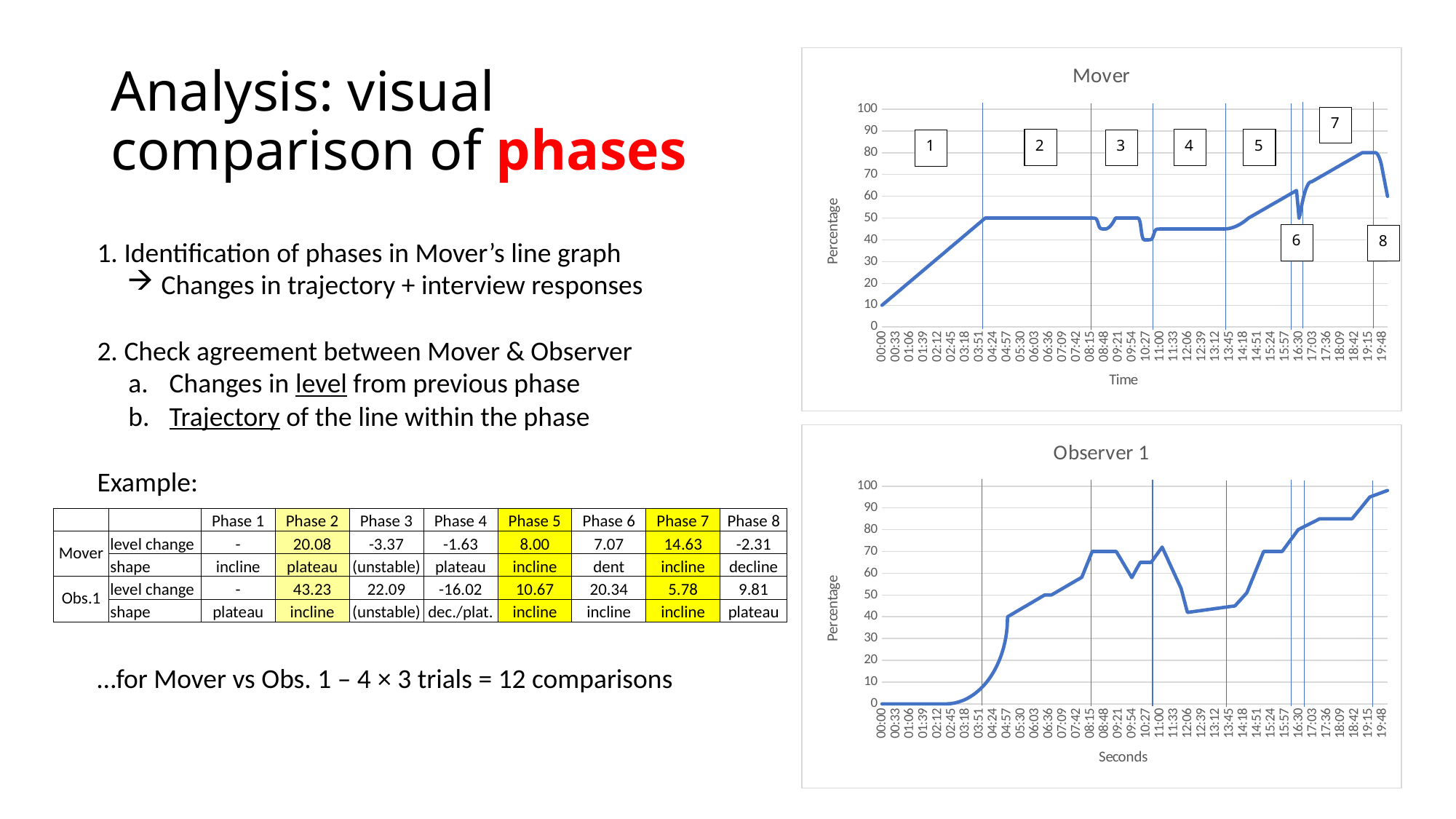
On the Mover chart, is the value at 06:03 greater or less than 40? greater What is the x-axis label of the Observer 1 chart? Seconds On the Observer 1 chart, is the value at 02:12 greater or less than 10? less What kind of chart is the Mover chart? line chart On the Mover chart, does the line rise or fall between 19:15 and 19:48? fall On the Observer 1 chart, is the value at 19:48 greater or less than 90? greater How many numbered phase markers are shown on the Mover chart? 8 On the Observer 1 chart, does the line rise or fall between 03:51 and 08:15? rise What kind of chart is the Observer 1 chart? line chart